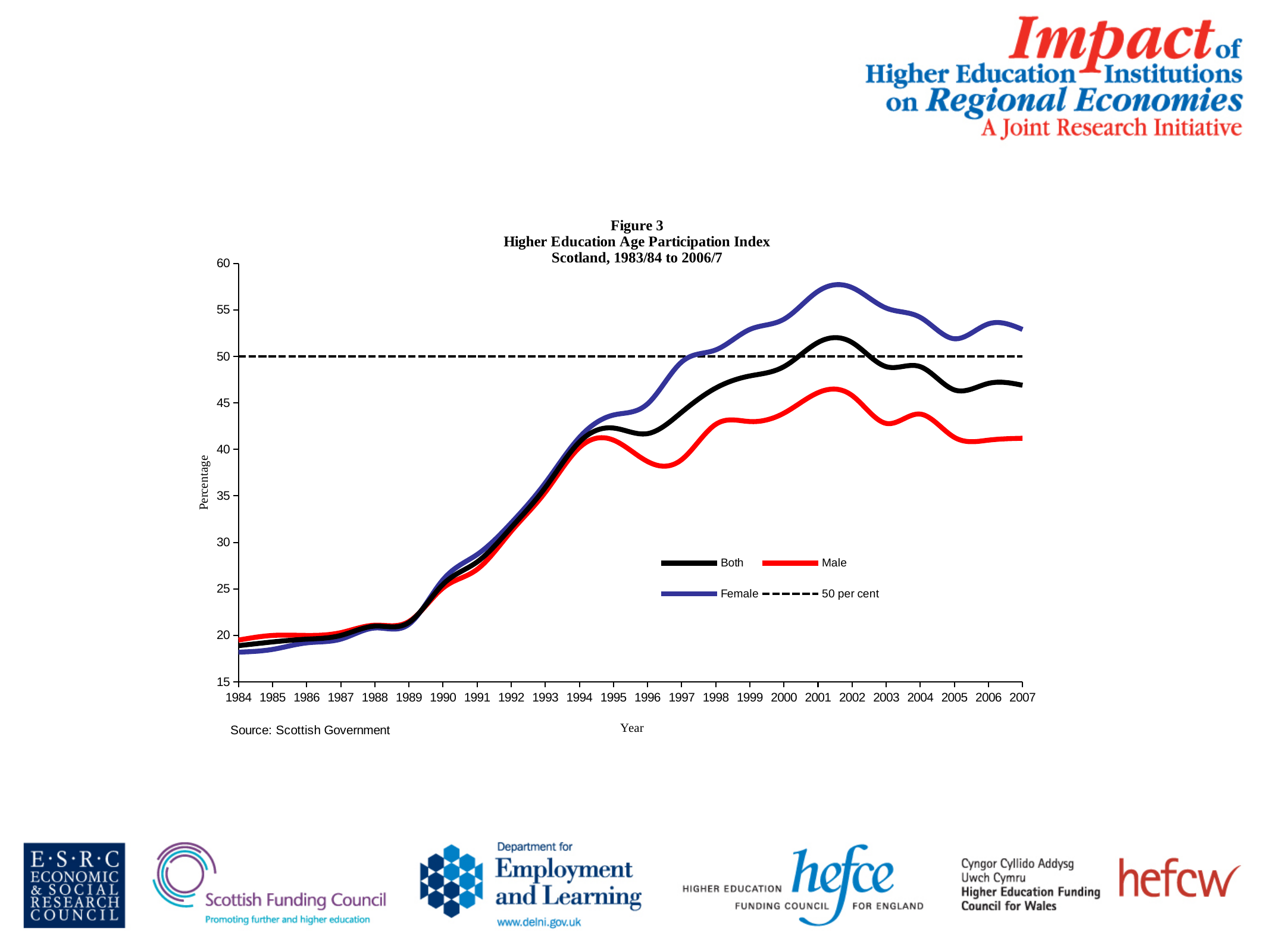
What is the title of the chart? Figure 3 Higher Education Age Participation Index Scotland, 1983/84 to 2006/7 Is the Male value higher in 2001 or in 2005? 2001 How many entries does the legend of the chart list? 4 What does the dashed horizontal line on the chart represent? 50 per cent Does the Both series rise or fall between 1989 and 1994? rise Is the value for Female in 1984 greater or less than 20? less Is the value for Male in 1996 greater or less than 40? less Is the value for Female in 2002 greater or less than 55? greater In 2007, which series has the higher value, Female or Male? Female What kind of chart is shown in Figure 3? line chart How many year labels are shown on the x axis? 24